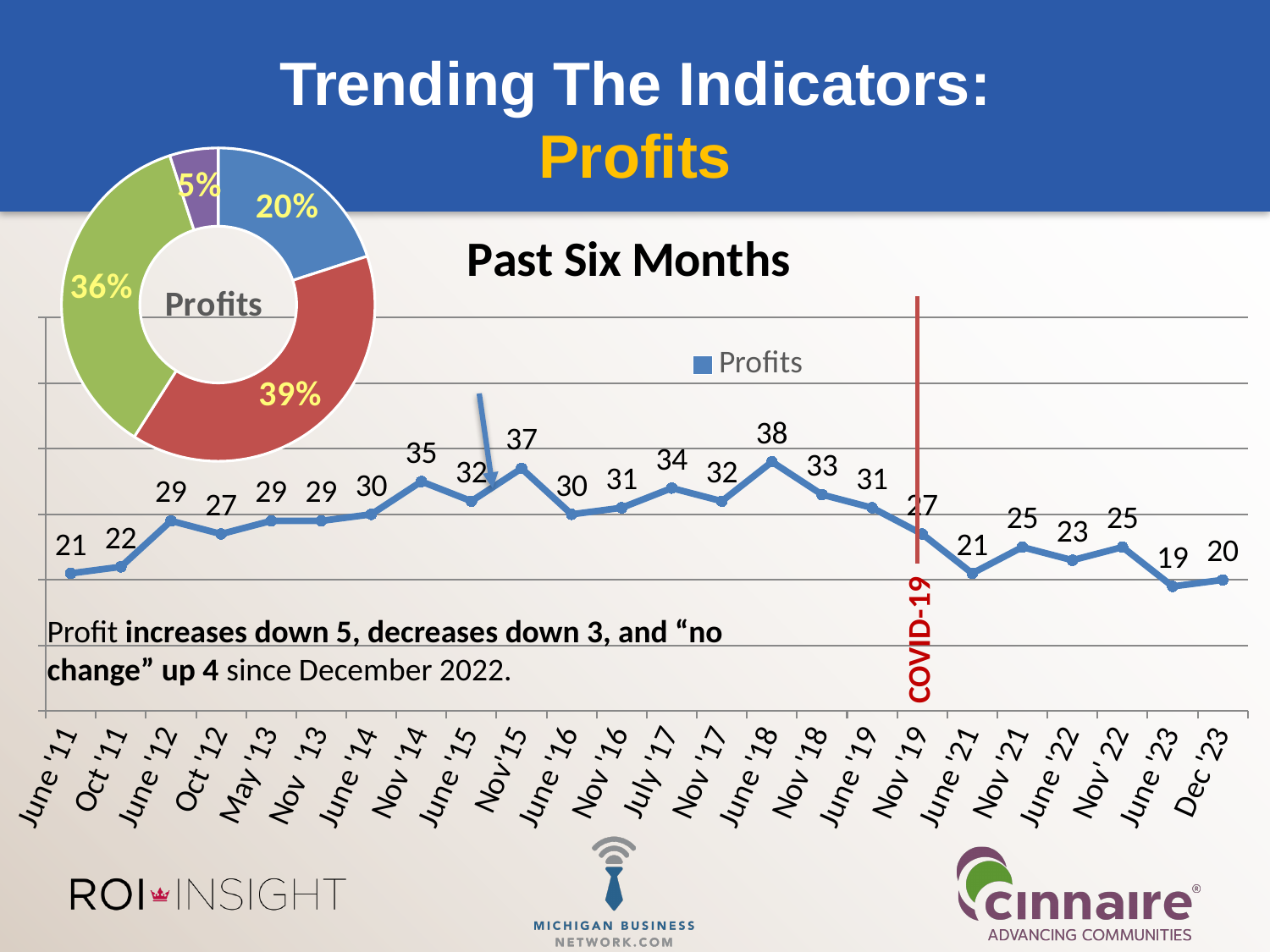
In the line chart titled "Past Six Months", what is the value for June '18? 38 In the line chart titled "Past Six Months", what is the value for Nov '15? 37 In the line chart titled "Past Six Months", what is the difference between the values for June '18 and June '23? 19 In the line chart titled "Past Six Months", what is the value for Dec '23? 20 In the line chart titled "Past Six Months", which date has the lowest value? June '23 In the line chart titled "Past Six Months", which is larger, the value for Nov '14 or the value for Nov '18? Nov '14 In the line chart titled "Past Six Months", which date has the highest value? June '18 In the line chart titled "Past Six Months", do the values rise or fall from June '19 to June '21? fall In the line chart titled "Past Six Months", how many data points are plotted? 24 In the donut chart titled "Profits" at the top left, what is the share of the largest slice? 39% In the line chart titled "Past Six Months", how many series does the legend list? 1 In the donut chart titled "Profits" at the top left, how many slices are there? 4